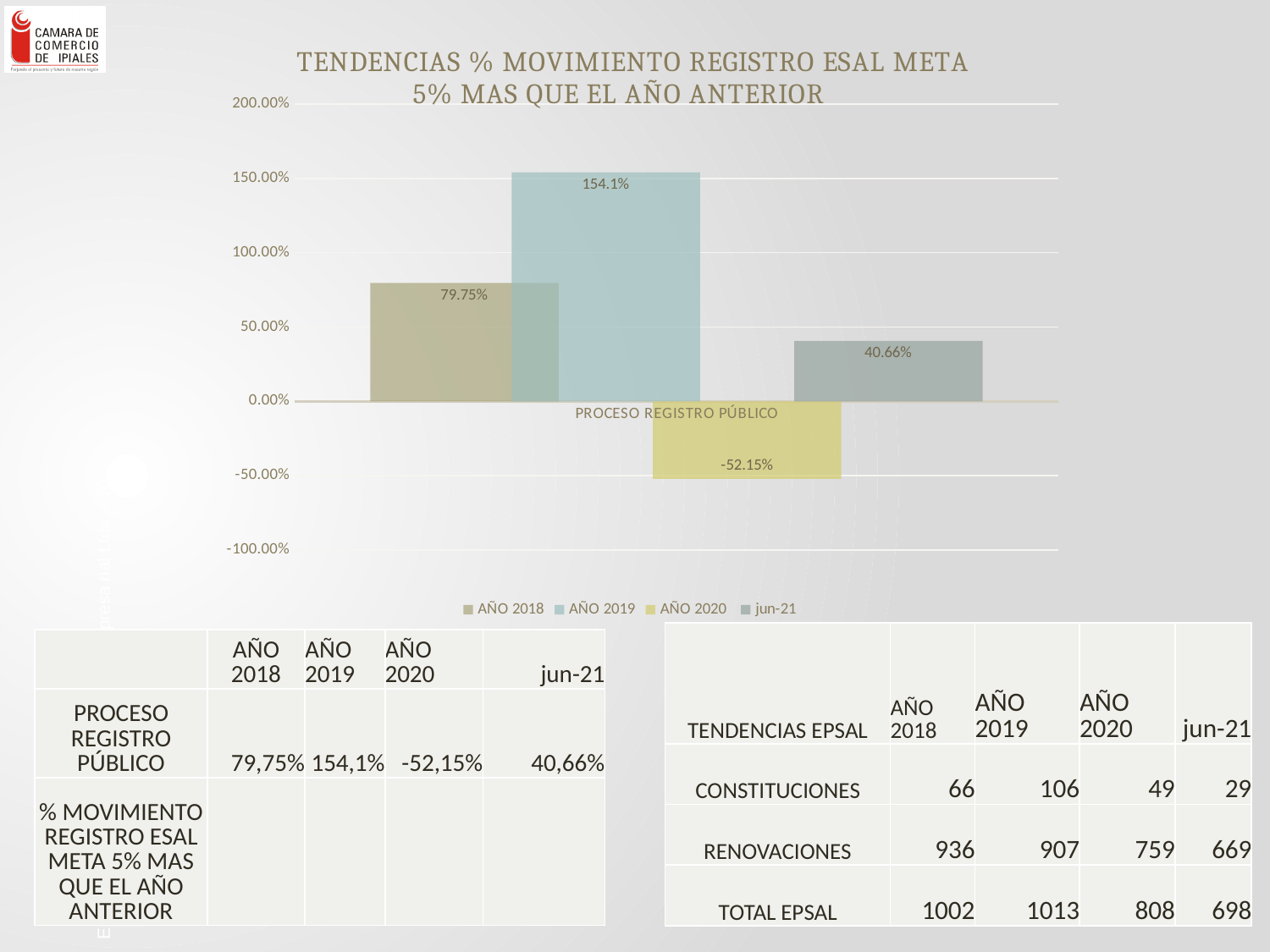
What is the value for AÑO 2020 in the chart? -52.15% Which series has the lowest value in the chart? AÑO 2020 How many series does the legend list? 4 Is the value for AÑO 2019 greater or less than 100.00%? greater Which is larger, the value for AÑO 2018 or the value for jun-21? AÑO 2018 What is the value for jun-21 in the chart? 40.66% What is the category label shown on the x axis of the chart? PROCESO REGISTRO PÚBLICO What kind of chart is shown on the slide? Bar chart What is the value for AÑO 2019 in the chart? 154.1% Which series has the highest value in the chart? AÑO 2019 What is the value for AÑO 2018 in the chart? 79.75% What is the difference between the AÑO 2019 value and the AÑO 2018 value? 74.35%